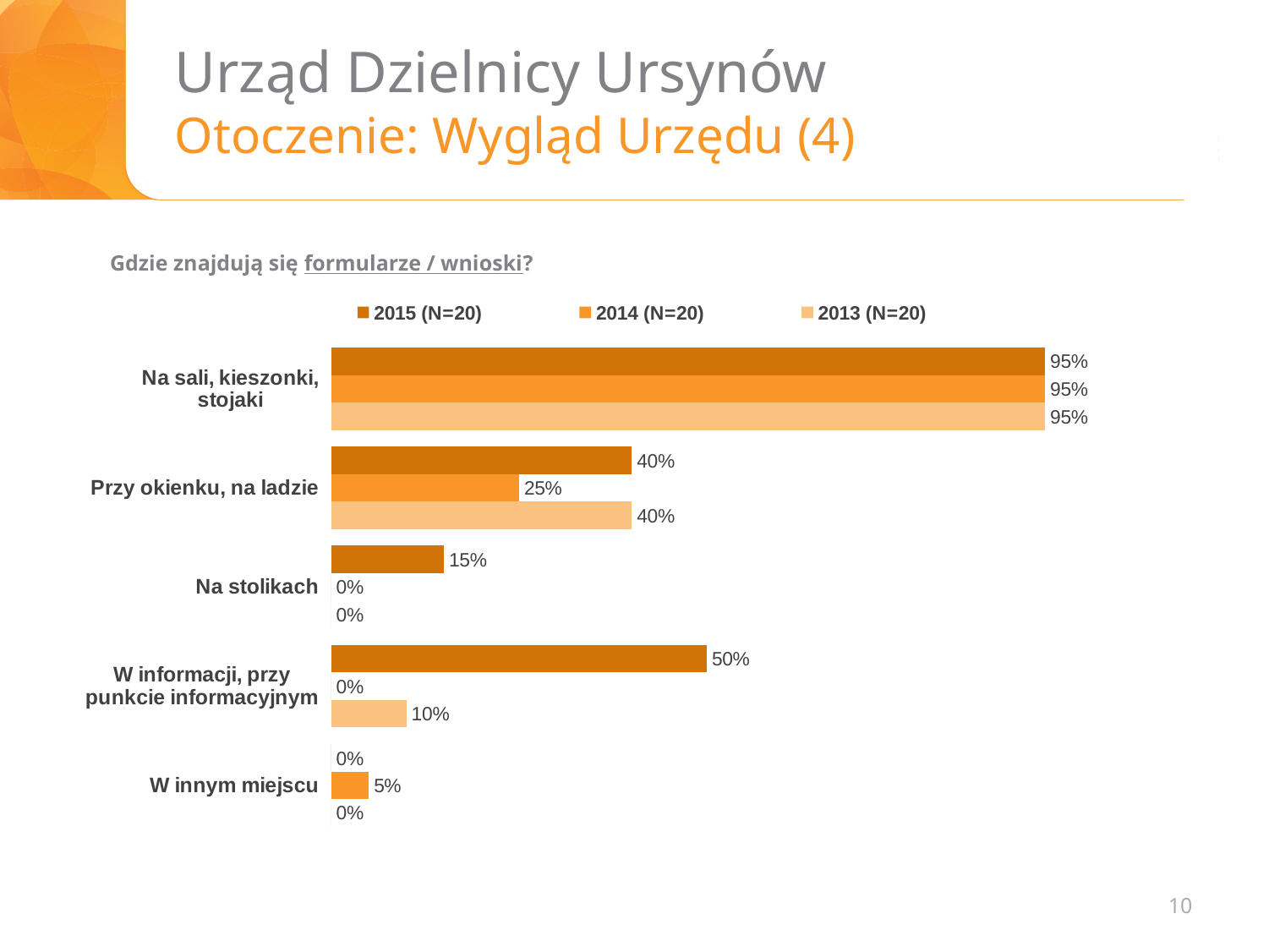
How many series does the legend list? 3 Which category has the highest 2015 (N=20) value? Na sali, kieszonki, stojaki What is the 2015 (N=20) value for "Przy okienku, na ladzie"? 40% What is the 2013 (N=20) value for "W informacji, przy punkcie informacyjnym"? 10% What kind of chart is shown on the slide? Bar chart Which is larger for "Na stolikach": the 2015 (N=20) value or the 2014 (N=20) value? 2015 (N=20) How many categories are shown on the chart? 5 What is the 2014 (N=20) value for "W innym miejscu"? 5% What is the difference between the 2015 (N=20) and 2014 (N=20) values for "Przy okienku, na ladzie"? 15% Which category has the lowest 2015 (N=20) value? W innym miejscu What is the difference between the 2015 (N=20) and 2013 (N=20) values for "W informacji, przy punkcie informacyjnym"? 40% What question does the chart answer, according to the text above it? Gdzie znajdują się formularze / wnioski?